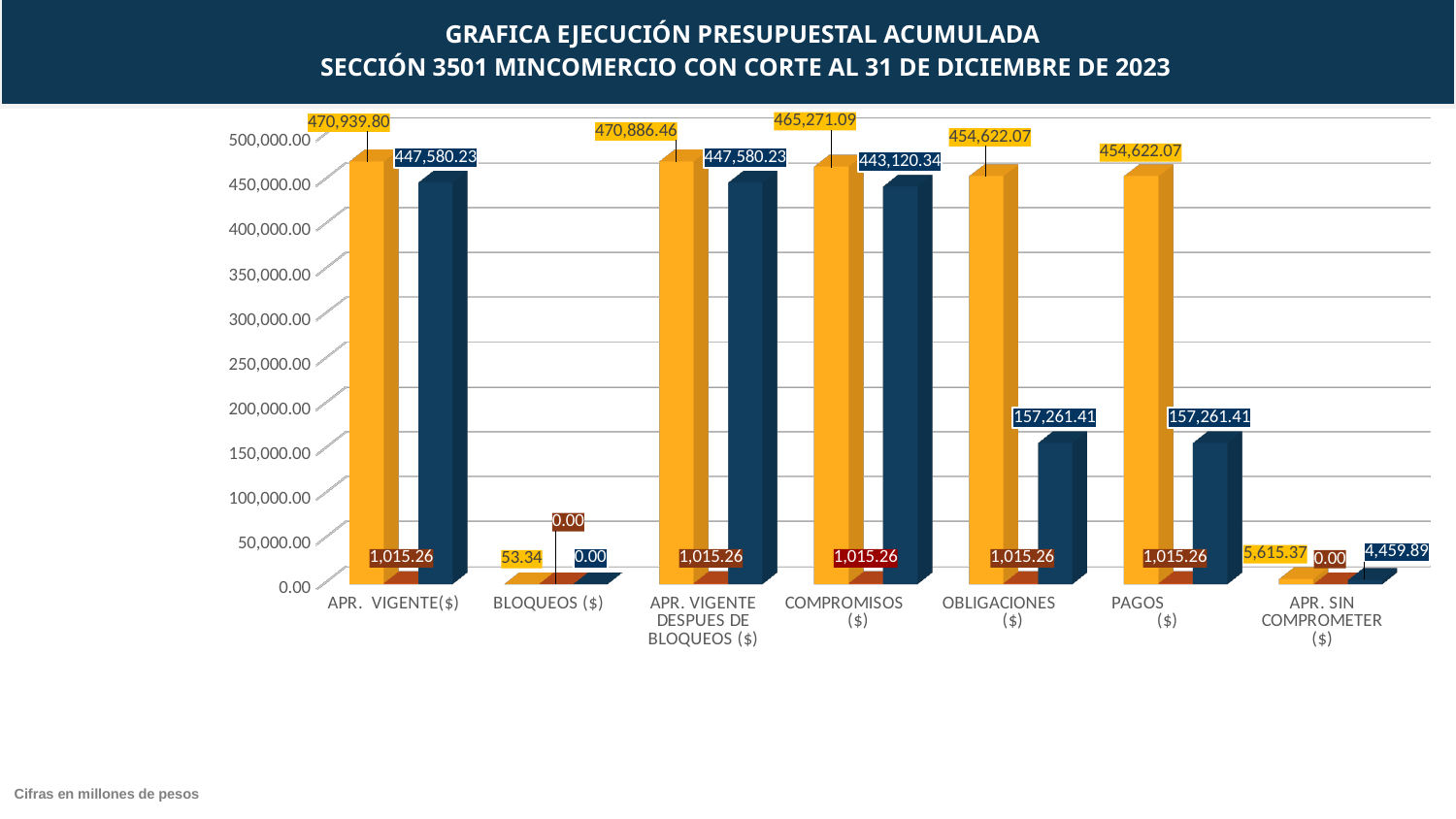
What is the value of the yellow bar for APR. VIGENTE($)? 470,939.80 What is the difference between the yellow bar and the dark blue bar for APR. VIGENTE($)? 23,359.57 What kind of chart is shown on the slide? bar chart Which category has the highest yellow bar? APR. VIGENTE($) Is the yellow bar for OBLIGACIONES ($) greater or less than 400,000.00? greater How many categories are shown along the x axis of the chart? 7 What unit note is printed at the bottom left of the slide? Cifras en millones de pesos What is the value of the dark blue bar for COMPROMISOS ($)? 443,120.34 What is the value of the yellow bar for BLOQUEOS ($)? 53.34 Which is larger: the dark blue bar for COMPROMISOS ($) or the dark blue bar for PAGOS ($)? COMPROMISOS ($) What is the value of the dark blue bar for APR. SIN COMPROMETER ($)? 4,459.89 What is the value of the dark blue bar for OBLIGACIONES ($)? 157,261.41